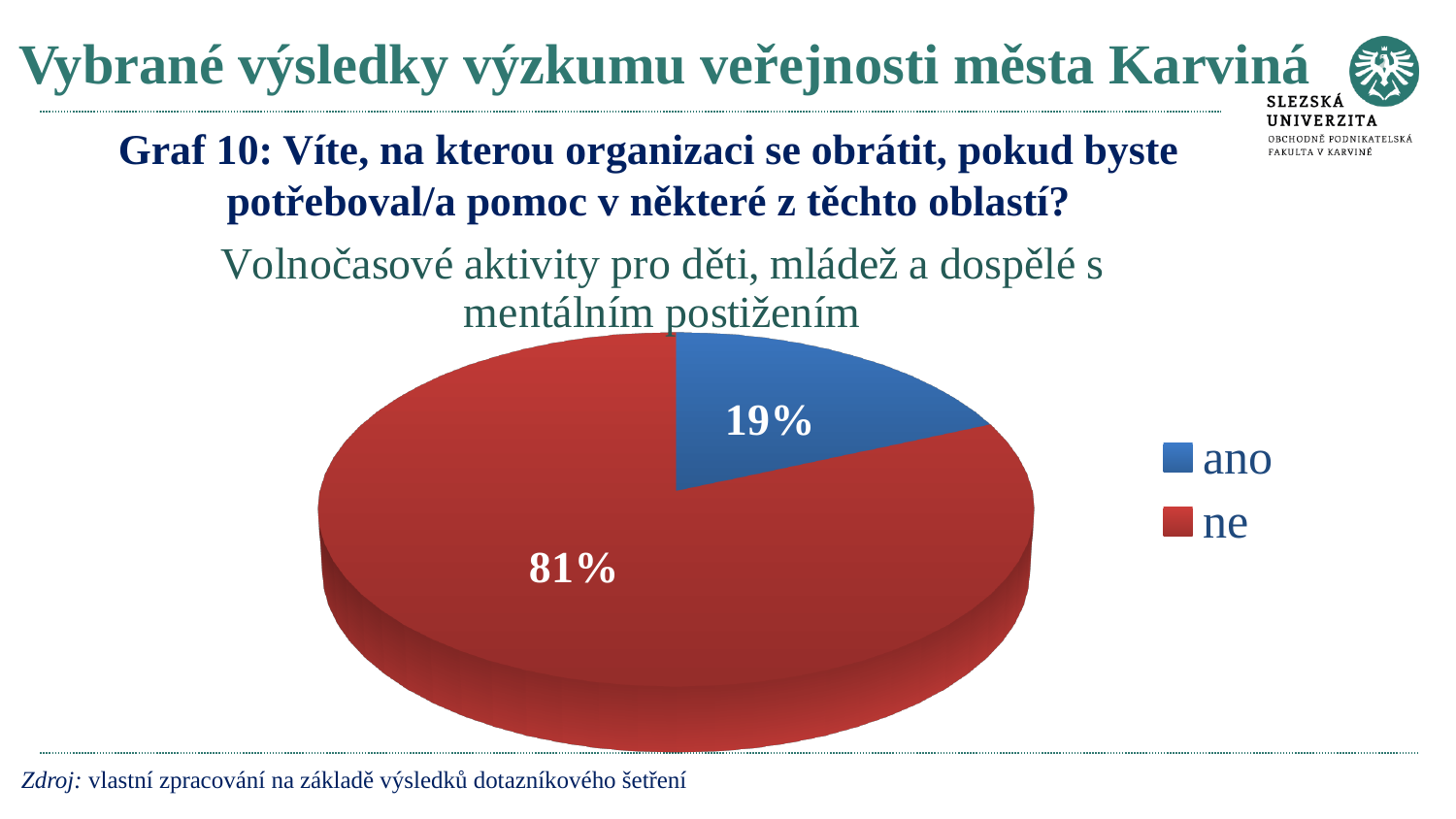
What kind of chart is shown on the slide? pie chart What share of the pie does "ne" represent? 81% Which is larger, the "ano" slice or the "ne" slice? ne Which category has the smallest slice of the pie? ano What is the title of the chart above the pie? Volnočasové aktivity pro děti, mládež a dospělé s mentálním postižením What colour is the "ano" slice? blue How many categories does the pie chart show? 2 Which category has the largest slice of the pie? ne What is the difference in percentage points between the "ne" and "ano" slices? 62 How many entries does the legend list? 2 What share of the pie does "ano" represent? 19%